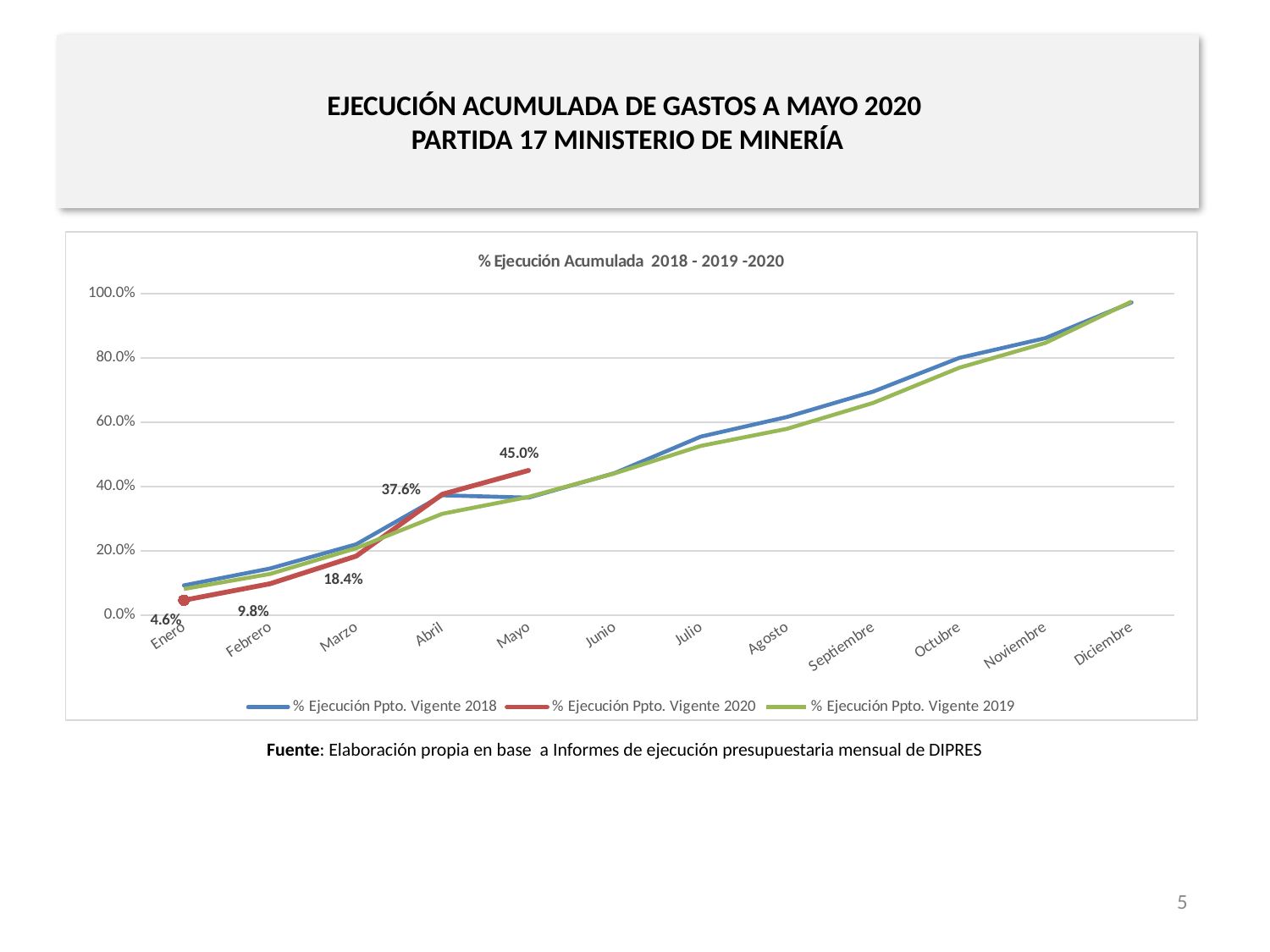
In Abril, which series has the larger value: % Ejecución Ppto. Vigente 2020 or % Ejecución Ppto. Vigente 2019? % Ejecución Ppto. Vigente 2020 What kind of chart is shown on the slide? Line chart What is the value for Abril in the % Ejecución Ppto. Vigente 2020 series? 37.6% What is the difference between the Mayo and Abril values in the % Ejecución Ppto. Vigente 2020 series? 7.4% What is the difference between the Abril and Marzo values in the % Ejecución Ppto. Vigente 2020 series? 19.2% Is the value for Diciembre in the % Ejecución Ppto. Vigente 2019 series greater or less than 80%? greater How many series does the legend list? 3 What is the value for Marzo in the % Ejecución Ppto. Vigente 2020 series? 18.4% What is the value for Enero in the % Ejecución Ppto. Vigente 2020 series? 4.6% How many months are shown on the x axis? 12 Do the values of the % Ejecución Ppto. Vigente 2018 series rise or fall from Enero to Diciembre? Rise What is the value for Mayo in the % Ejecución Ppto. Vigente 2020 series? 45.0%